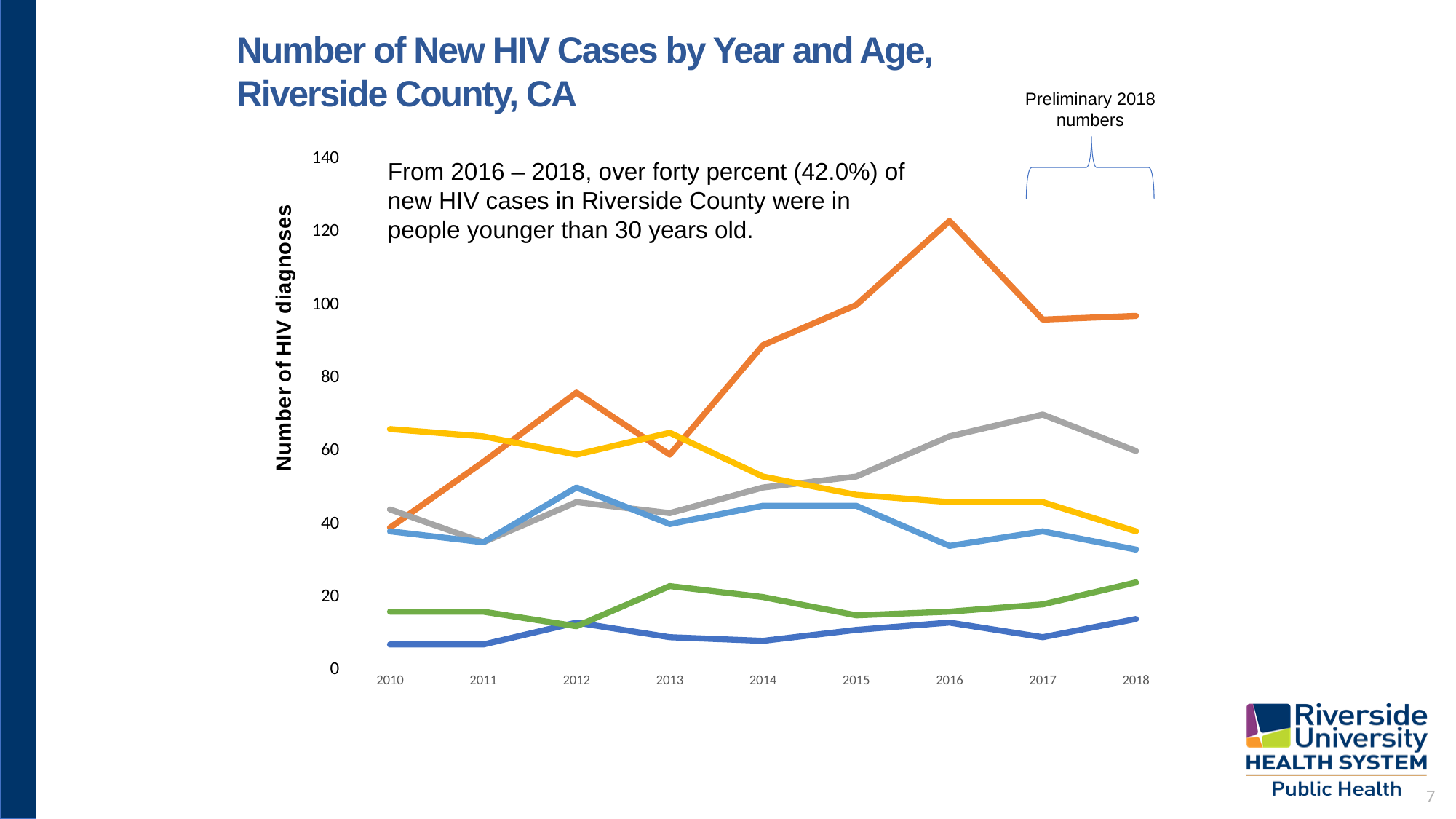
Is the value of the orange line in 2016 greater or less than 100? greater In 2018, which line has the larger value, the orange line or the gray line? orange line What is the highest value shown on the vertical axis of the chart? 140 Does the orange line rise or fall between 2013 and 2016? rise In which year does the orange line reach its highest point? 2016 Is the value of the dark blue line in 2010 greater or less than 20? less How many years are shown along the x axis of the chart? 9 In which year is the orange line at its lowest point? 2010 Is the value of the gray line in 2017 greater or less than 60? greater What is the label of the vertical axis of the chart? Number of HIV diagnoses What kind of chart is shown on the slide? line chart